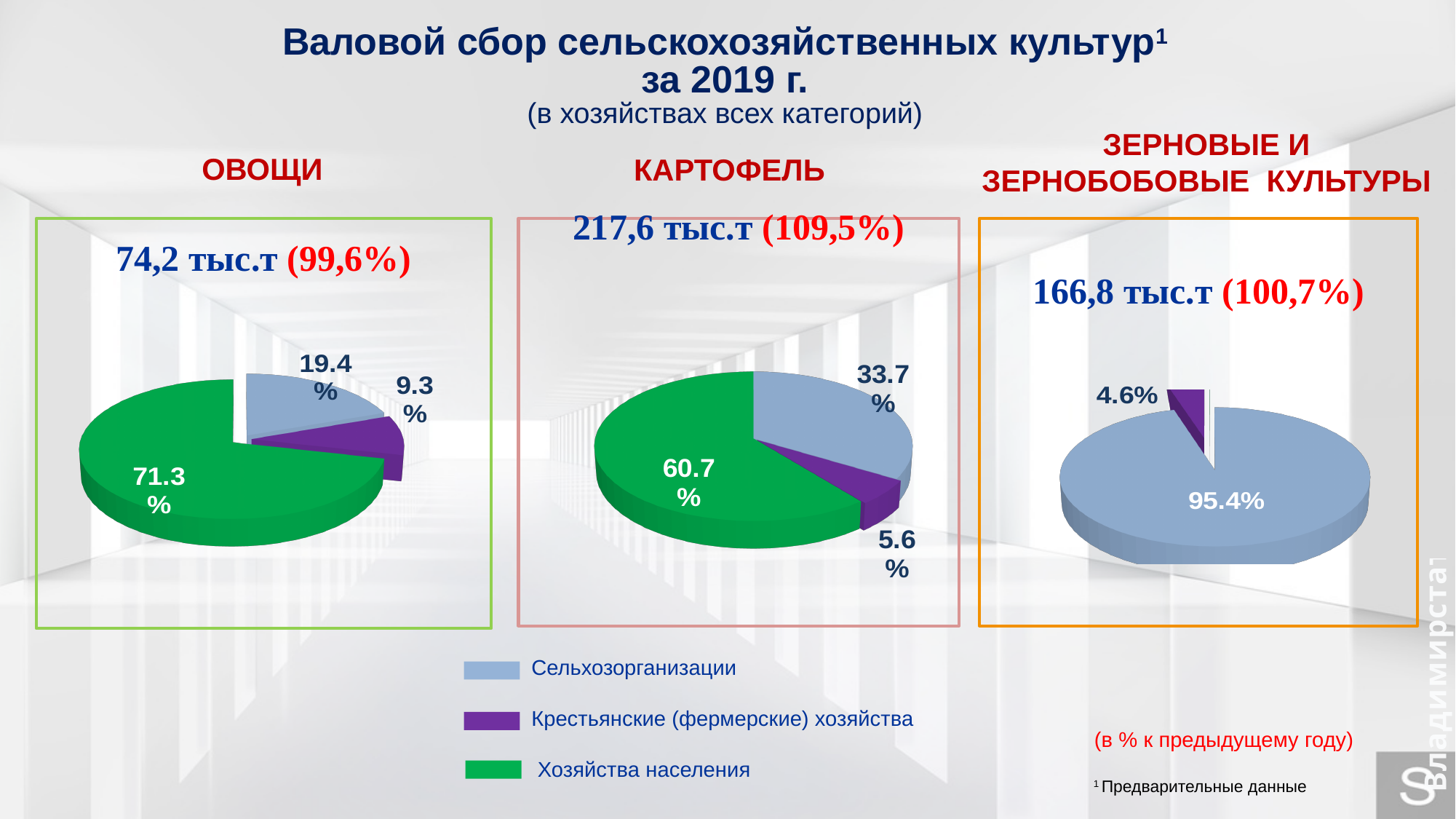
How many categories does the shared legend list? 3 What total gross harvest is printed above the КАРТОФЕЛЬ pie chart? 217,6 тыс.т (109,5%) On the КАРТОФЕЛЬ pie chart, which category has the largest slice? Хозяйства населения On the ОВОЩИ pie chart, which category has the smallest slice? Крестьянские (фермерские) хозяйства How many slices does the ЗЕРНОВЫЕ И ЗЕРНОБОБОВЫЕ КУЛЬТУРЫ pie chart have? 2 On the КАРТОФЕЛЬ pie chart, what is the difference between the Хозяйства населения share and the Сельхозорганизации share? 27.0% On the ОВОЩИ pie chart, what share is labelled for Сельхозорганизации? 19.4% On the КАРТОФЕЛЬ pie chart, what share is labelled for Крестьянские (фермерские) хозяйства? 5.6% What type of chart is used for ОВОЩИ, КАРТОФЕЛЬ and ЗЕРНОВЫЕ И ЗЕРНОБОБОВЫЕ КУЛЬТУРЫ? Pie chart On the ЗЕРНОВЫЕ И ЗЕРНОБОБОВЫЕ КУЛЬТУРЫ pie chart, what share is labelled for Сельхозорганизации? 95.4% Which is larger: the Сельхозорганизации share on the ОВОЩИ chart or on the КАРТОФЕЛЬ chart? КАРТОФЕЛЬ On the ОВОЩИ pie chart, what share is labelled for the green slice (Хозяйства населения)? 71.3%